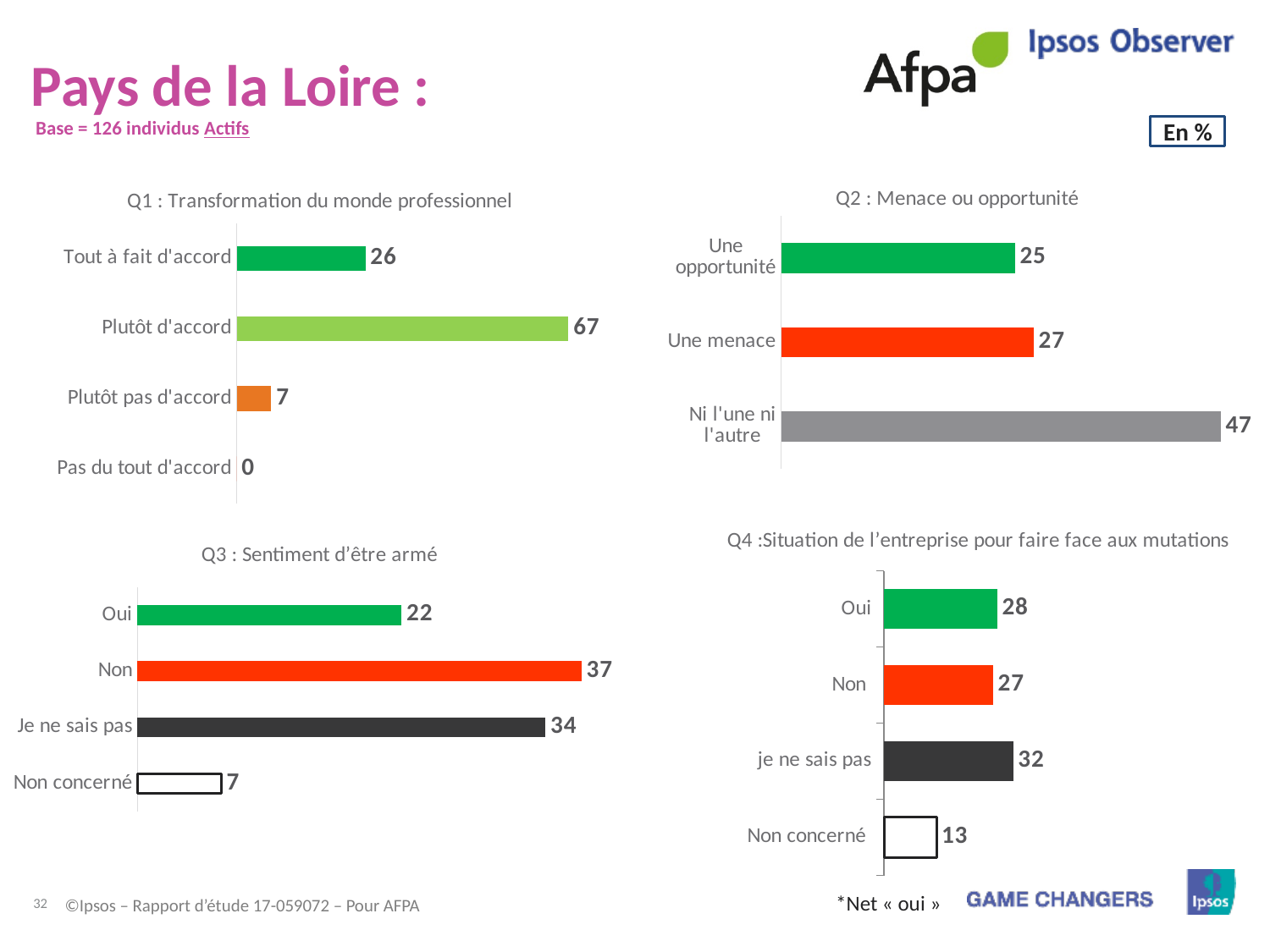
In the chart 'Q4 : Situation de l'entreprise pour faire face aux mutations', which category has the highest value? je ne sais pas In the chart 'Q3 : Sentiment d'être armé', what is the value for 'Non'? 37 In the chart 'Q3 : Sentiment d'être armé', which category has the highest value? Non In the chart 'Q2 : Menace ou opportunité', what is the value for 'Ni l'une ni l'autre'? 47 What type of chart is 'Q1 : Transformation du monde professionnel'? Bar chart In the chart 'Q1 : Transformation du monde professionnel', which category has the lowest value? Pas du tout d'accord In the chart 'Q1 : Transformation du monde professionnel', what is the value for 'Plutôt d'accord'? 67 In the chart 'Q3 : Sentiment d'être armé', what is the difference between 'Non' and 'Oui'? 15 In the chart 'Q4 : Situation de l'entreprise pour faire face aux mutations', what is the value for 'Non concerné'? 13 In the chart 'Q2 : Menace ou opportunité', how many categories are shown? 3 In the chart 'Q1 : Transformation du monde professionnel', what is the difference between 'Plutôt d'accord' and 'Tout à fait d'accord'? 41 In the chart 'Q2 : Menace ou opportunité', which is larger, 'Une opportunité' or 'Une menace'? Une menace